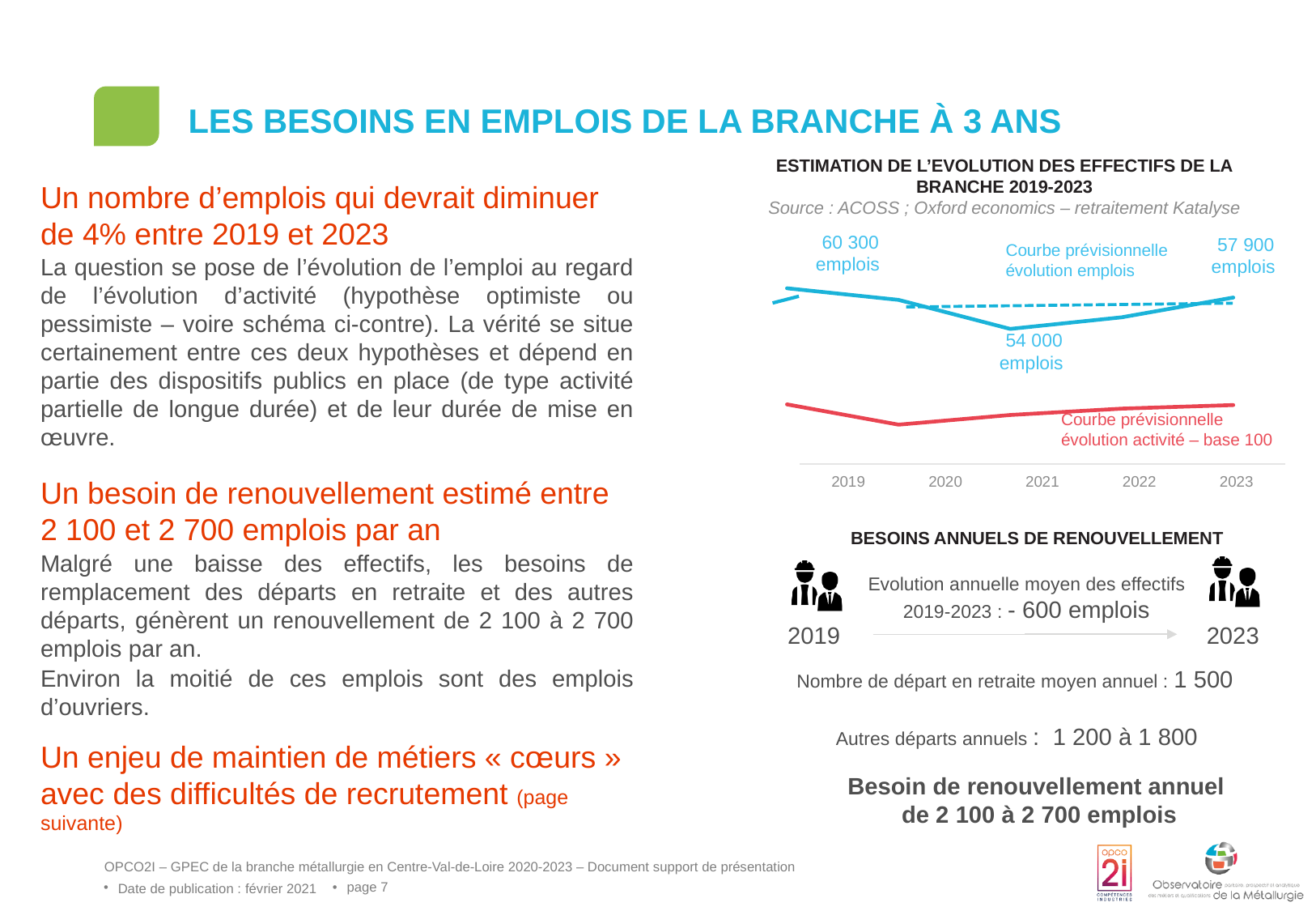
Which year has the lowest labelled jobs value on the chart? 2021 What does the red curve on the chart represent? Courbe prévisionnelle évolution activité – base 100 What is the labelled number of jobs (emplois) for 2023 on the chart? 57 900 emplois Does the solid blue jobs curve rise or fall between 2019 and 2021? fall What is the difference between the labelled jobs value for 2019 and the labelled jobs value for 2023? 2 400 How many years are shown on the x axis of the chart? 5 What is the difference between the labelled jobs value for 2019 and the labelled jobs value for 2021? 6 300 What is the title of the chart? ESTIMATION DE L'EVOLUTION DES EFFECTIFS DE LA BRANCHE 2019-2023 What type of chart is shown on the slide? line chart What is the labelled number of jobs (emplois) for 2019 on the chart? 60 300 emplois What is the labelled number of jobs (emplois) at the low point of the solid blue curve in 2021? 54 000 emplois Which year has the larger labelled jobs value, 2019 or 2023? 2019